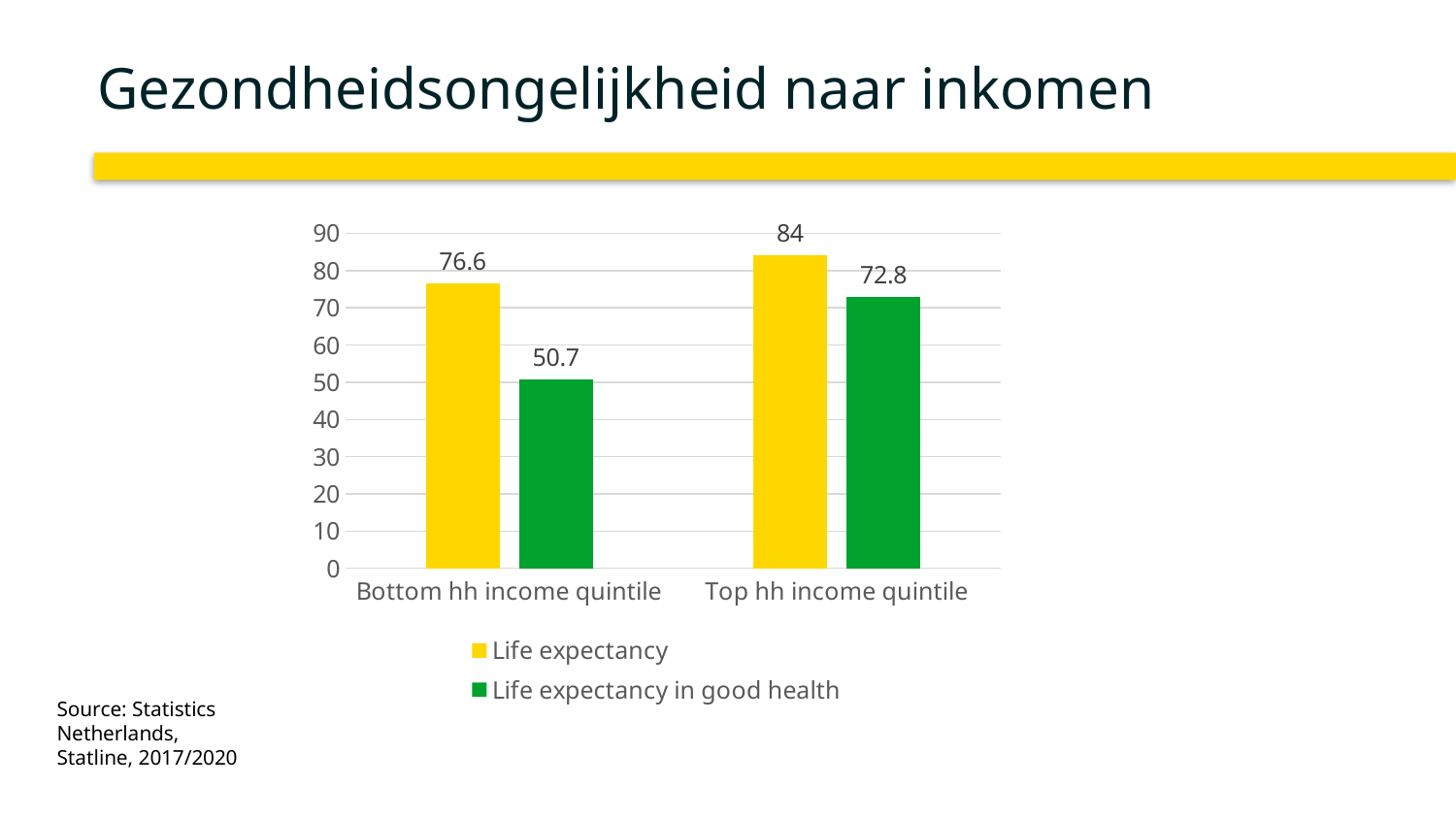
What is the difference in life expectancy in good health between the top and bottom hh income quintiles? 22.1 What is the life expectancy for the bottom hh income quintile? 76.6 Is life expectancy in good health higher for the top hh income quintile or the bottom hh income quintile? Top hh income quintile Which colour represents life expectancy in good health in the chart? Green What is the difference between life expectancy and life expectancy in good health for the bottom hh income quintile? 25.9 Which category has the highest life expectancy? Top hh income quintile Which category has the lowest life expectancy in good health? Bottom hh income quintile What is the life expectancy in good health for the top hh income quintile? 72.8 What type of chart is shown on the slide? Bar chart What is the life expectancy for the top hh income quintile? 84 What is the life expectancy in good health for the bottom hh income quintile? 50.7 How many series does the legend list? 2